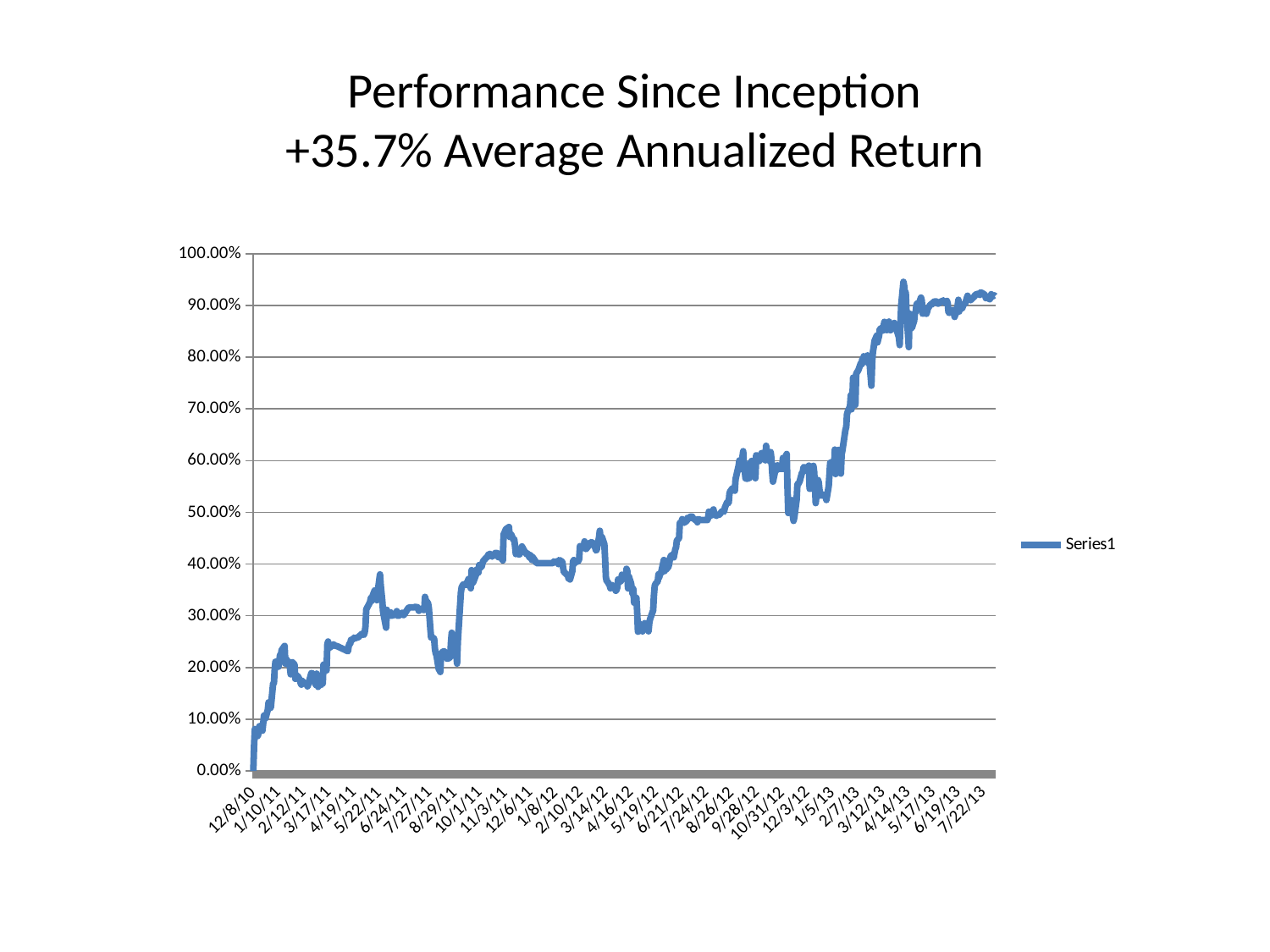
Is the value at 9/28/12 greater or less than 50.00%? greater Is the value at 4/14/13 greater or less than 80.00%? greater What kind of chart is shown on the slide? line chart Which date has the larger value, 12/8/10 or 7/22/13? 7/22/13 Is the value at 7/22/13 greater or less than 90.00%? greater What average annualized return is stated in the chart title? +35.7% Do the values generally rise or fall from 12/8/10 to 7/22/13? rise How many series does the legend list? 1 Which date has the larger value, 5/19/12 or 9/28/12? 9/28/12 What is the name of the series shown in the legend? Series1